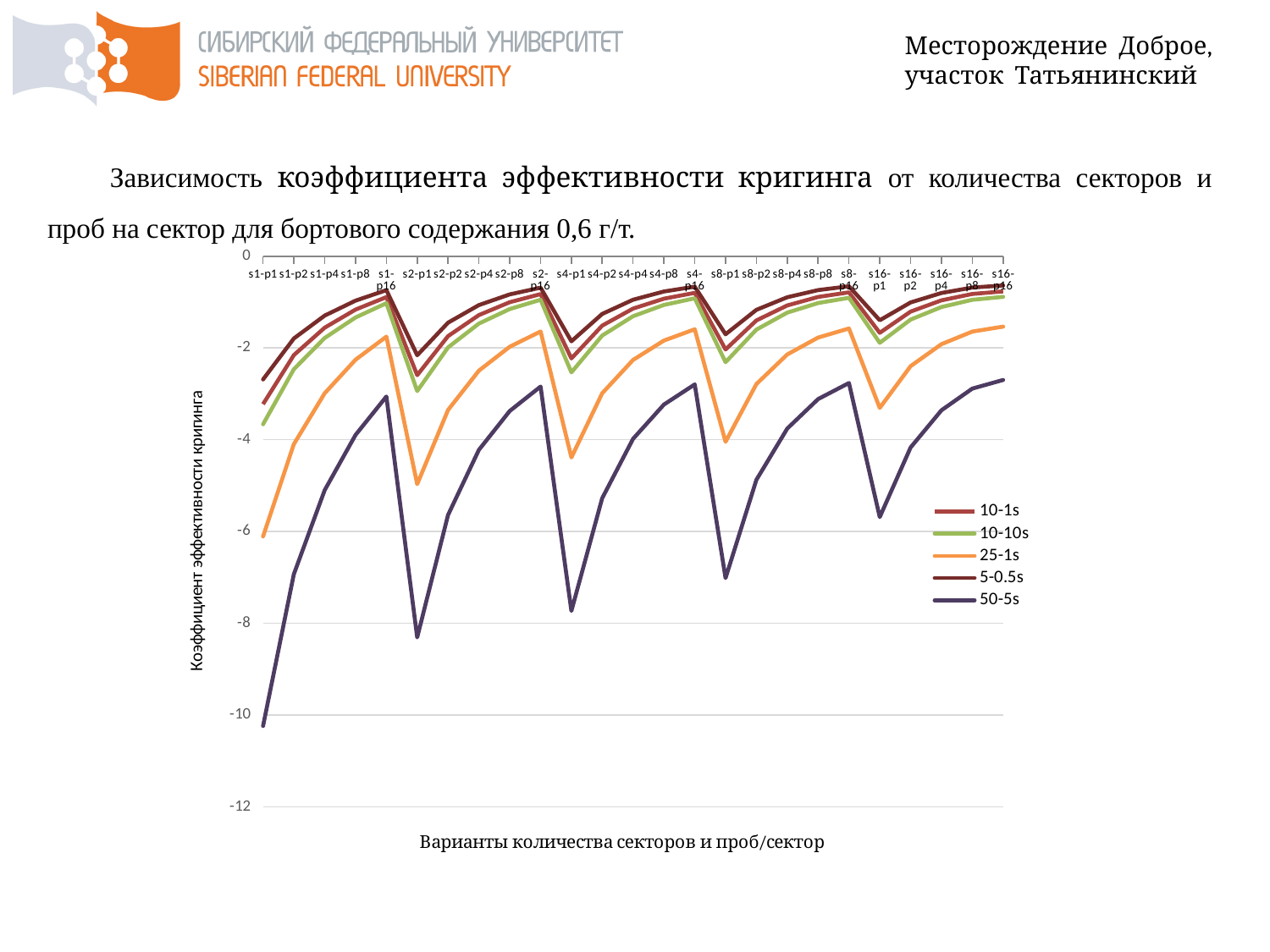
Is the value of the 25-1s series at s16-p16 greater or less than -2? greater What is the title of the y axis? Коэффициент эффективности кригинга How many series does the legend list? 5 Is the value of the 50-5s series at s1-p1 greater or less than -10? less Is the value of the 50-5s series at s2-p1 greater or less than -8? less At s8-p1, which series has the larger value: 10-10s or 25-1s? 10-10s Which series has the lowest value at s1-p1? 50-5s At s1-p1, which series has the larger value: 25-1s or 50-5s? 25-1s Which series has the lowest values across the whole chart? 50-5s What kind of chart is shown on the slide? line chart How many categories are on the x axis? 25 Does the 50-5s series rise or fall from s1-p1 to s1-p16? rise